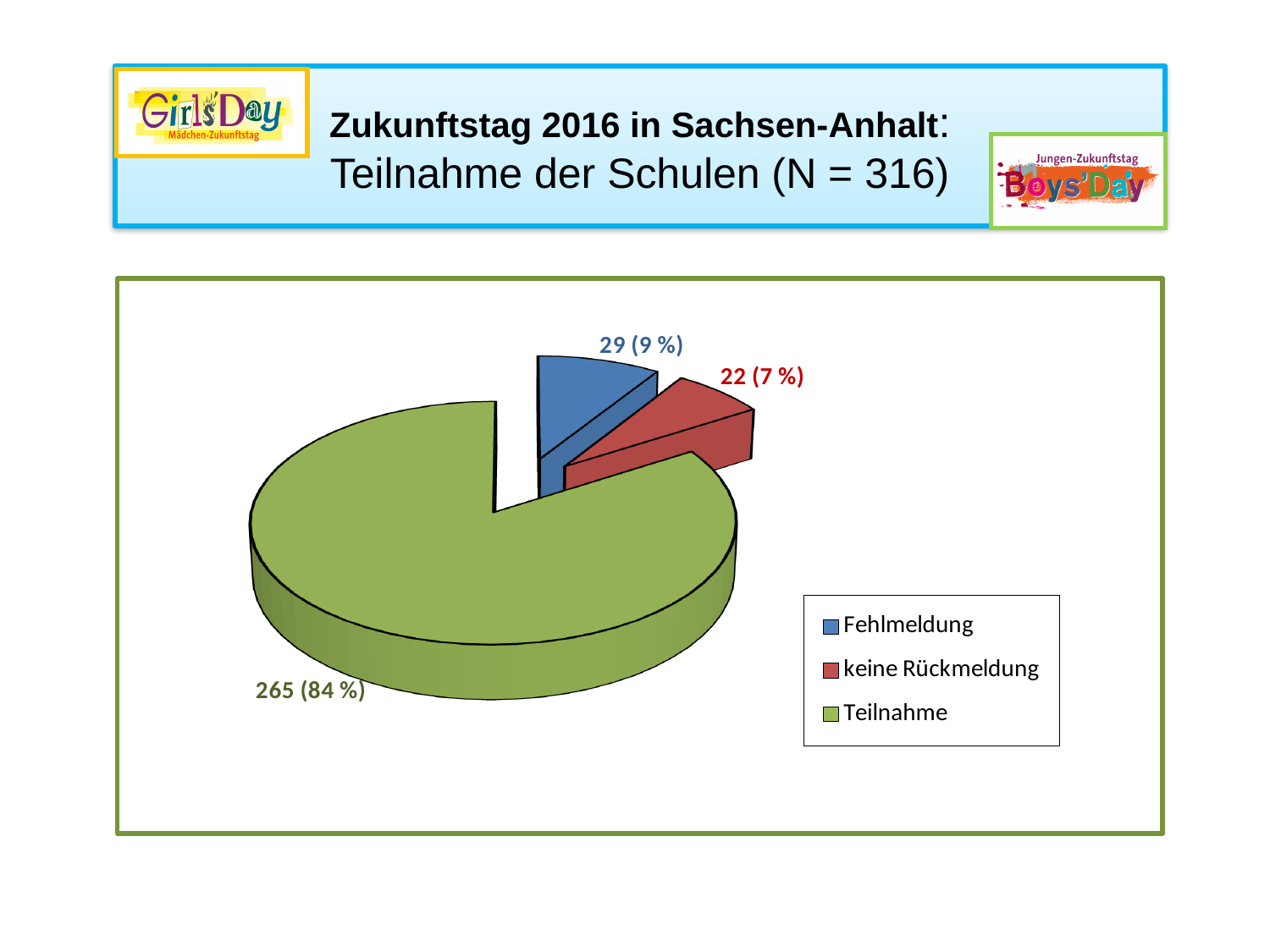
How many schools are in the Fehlmeldung category? 29 How many schools are in the keine Rückmeldung category? 22 What is the difference between the Fehlmeldung and keine Rückmeldung counts? 7 What share of the pie does Teilnahme represent? 84 % What share of the pie does keine Rückmeldung represent? 7 % What colour is the Teilnahme slice? green Which category has the largest slice? Teilnahme Which is larger, Fehlmeldung or keine Rückmeldung? Fehlmeldung Which category has the smallest slice? keine Rückmeldung How many schools are in the Teilnahme category? 265 How many categories does the legend list? 3 What kind of chart is shown on the slide? pie chart